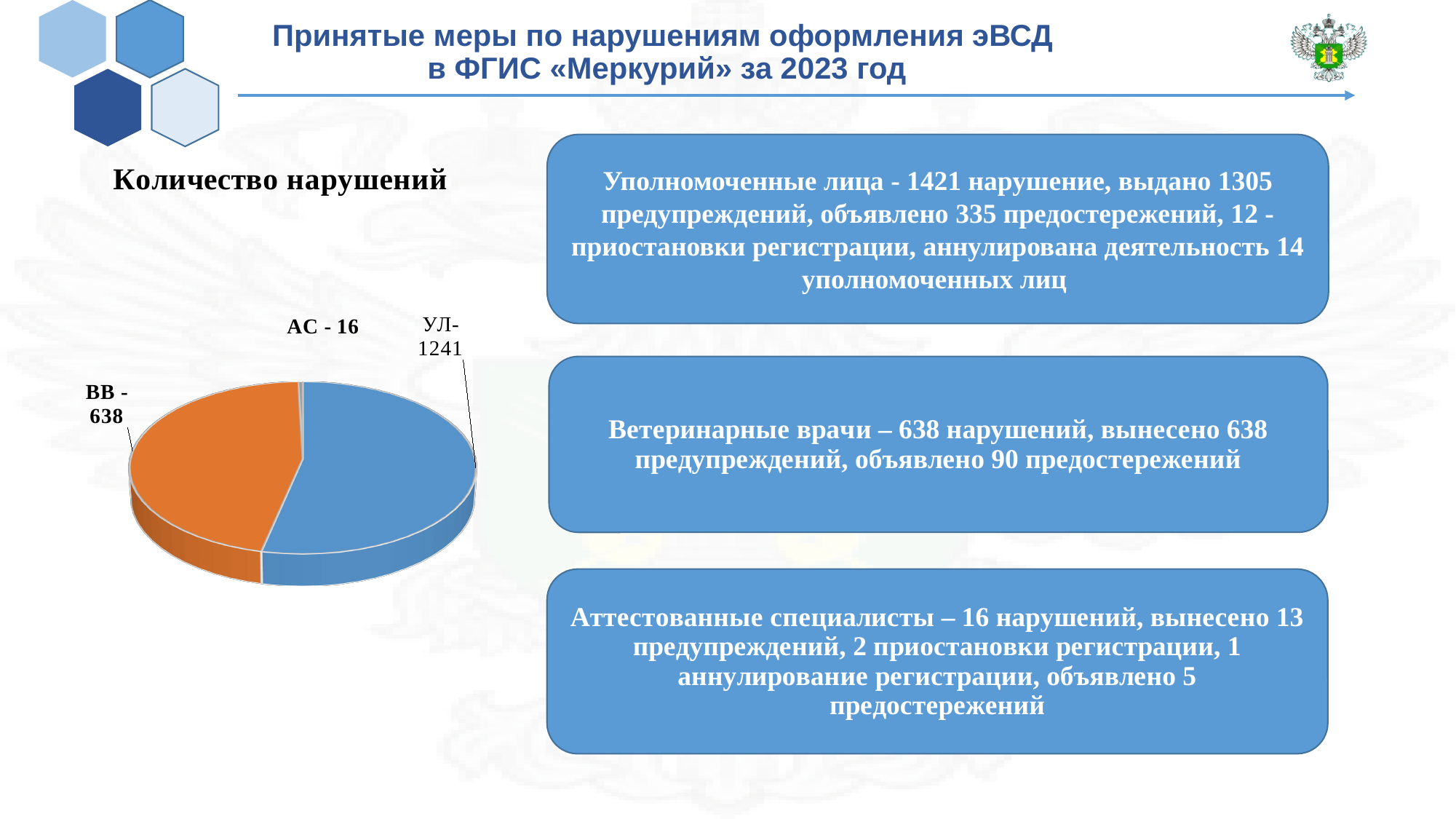
What is the difference between the values for ВВ and АС in the pie chart? 622 How many categories does the pie chart show? 3 What kind of chart is shown on the slide? Pie chart What is the difference between the values for УЛ and ВВ in the pie chart? 603 What is the total of all slices in the pie chart? 1895 What is the title of the chart on the slide? Количество нарушений What is the value for АС in the pie chart? 16 Which category has the largest slice in the pie chart? УЛ What is the value for УЛ in the pie chart? 1241 Which category has the smallest slice in the pie chart? АС Which is larger in the pie chart, ВВ or АС? ВВ What is the value for ВВ in the pie chart? 638